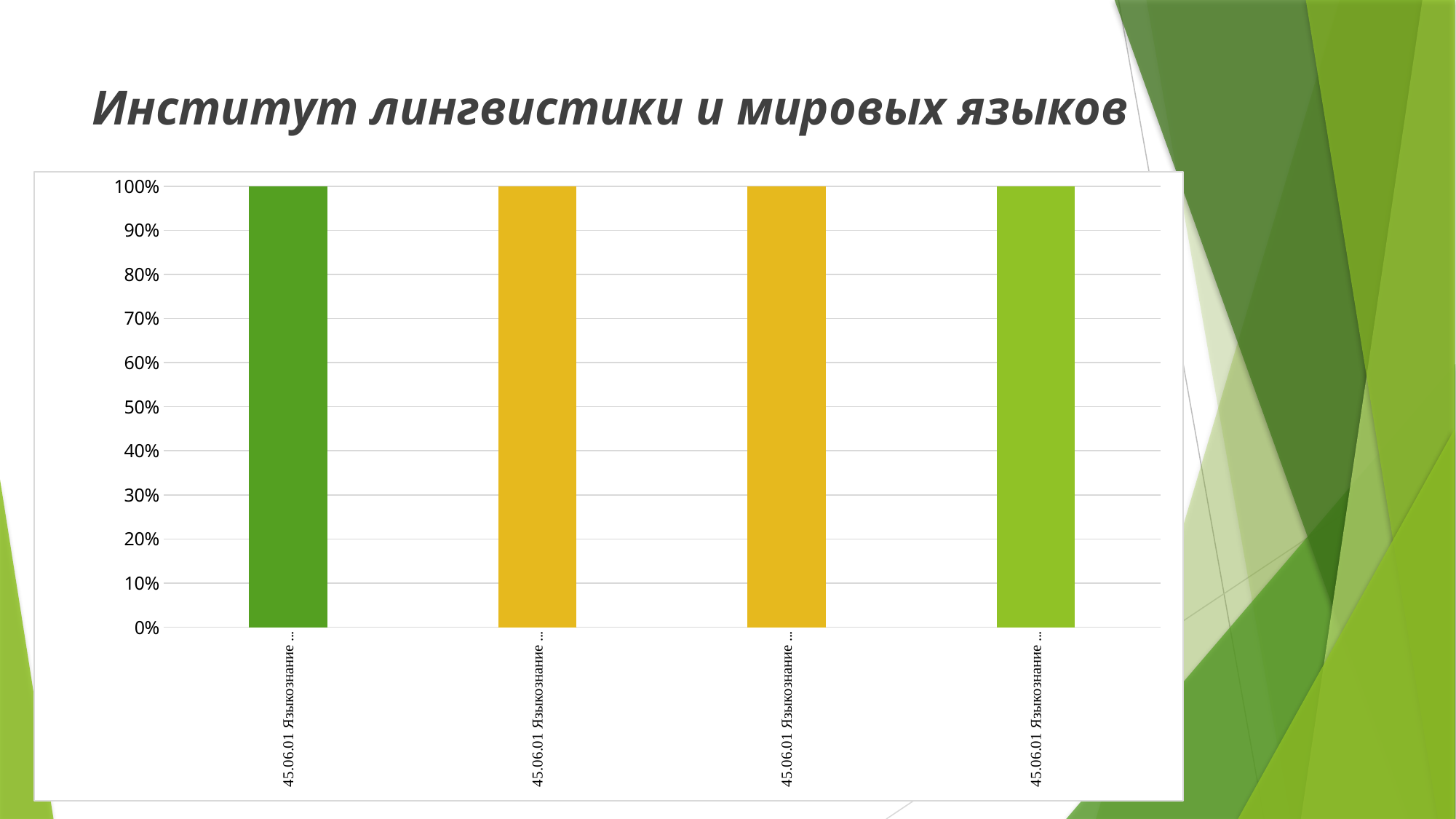
What value does the rightmost bar reach on the y axis? 100% Do the bar values rise, fall, or stay the same from left to right across the chart? stay the same What is the highest value shown on the y axis? 100% What value does the second bar from the left reach on the y axis? 100% What kind of chart is shown on the slide? bar chart What value does the first (leftmost) bar reach on the y axis? 100% What is the title of the slide above the chart? Институт лингвистики и мировых языков What is the difference between the value of the leftmost bar and the value of the rightmost bar? 0% How many bars are plotted in the chart? 4 Is the value of the third bar from the left greater or less than 50%? greater